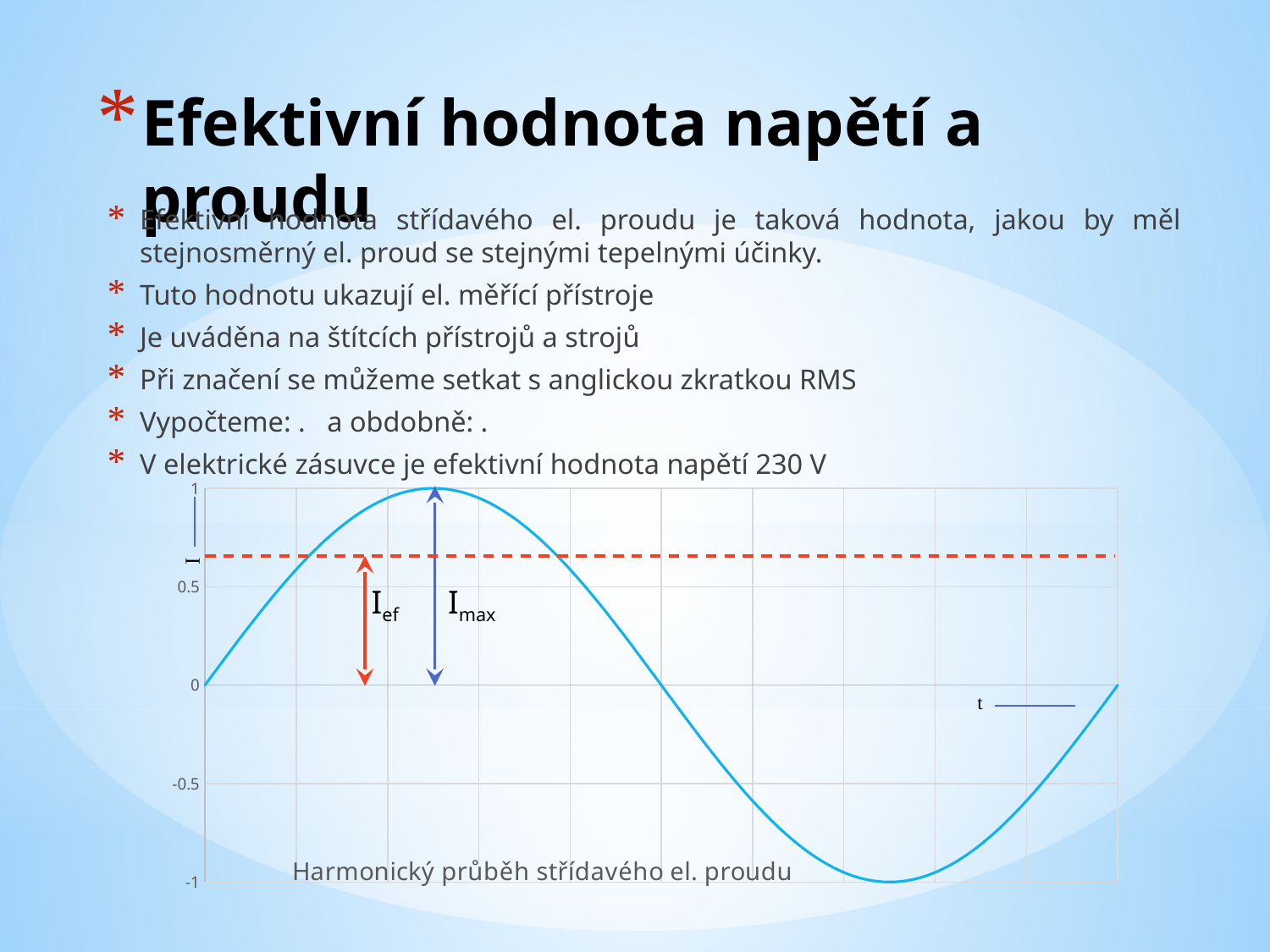
What is the minimum value reached by the curve on the vertical axis? -1 What is the title of the chart? Harmonický průběh střídavého el. proudu How many labelled tick values are shown on the vertical axis? 5 What is the maximum value reached by the curve on the vertical axis? 1 What kind of chart is shown on the slide? line chart Does the curve rise or fall immediately after t = 0? rise Is the level of the red dashed line (I_ef) greater or less than 1? less How many curves (series) are plotted on the chart? 1 What label is shown on the horizontal axis of the chart? t Which is larger, I_max or I_ef? I_max What is the value of the curve at the start of the horizontal axis (t = 0)? 0 Is the level of the red dashed line (I_ef) greater or less than 0.5? greater